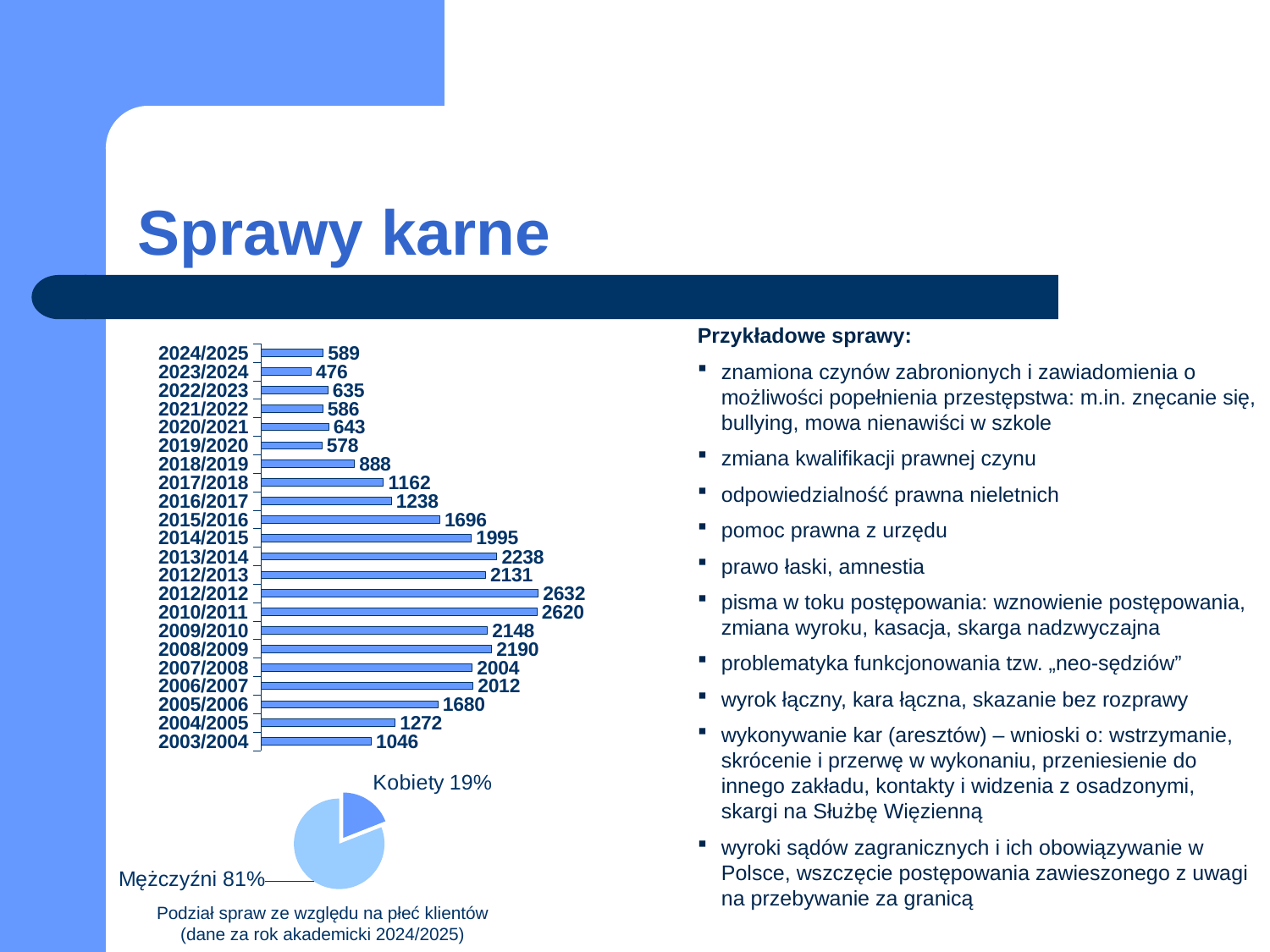
What kind of chart is the upper chart on the left of the slide? bar chart In the bar chart on the left of the slide, what is the value for 2003/2004? 1046 In the pie chart titled 'Podział spraw ze względu na płeć klientów', what share is labelled Mężczyźni? 81% In the bar chart on the left of the slide, what is the difference between the values for 2013/2014 and 2012/2013? 107 In the bar chart on the left of the slide, which is larger: the value for 2017/2018 or the value for 2016/2017? 2016/2017 In the bar chart on the left of the slide, which category has the lowest value? 2023/2024 In the bar chart on the left of the slide, what is the value for 2015/2016? 1696 In the bar chart on the left of the slide, what is the value for 2024/2025? 589 What kind of chart is the lower chart on the left of the slide? pie chart How many categories (academic years) does the bar chart on the left of the slide show? 22 In the bar chart on the left of the slide, which category has the highest value? 2012/2012 In the pie chart titled 'Podział spraw ze względu na płeć klientów', what share is labelled Kobiety? 19%